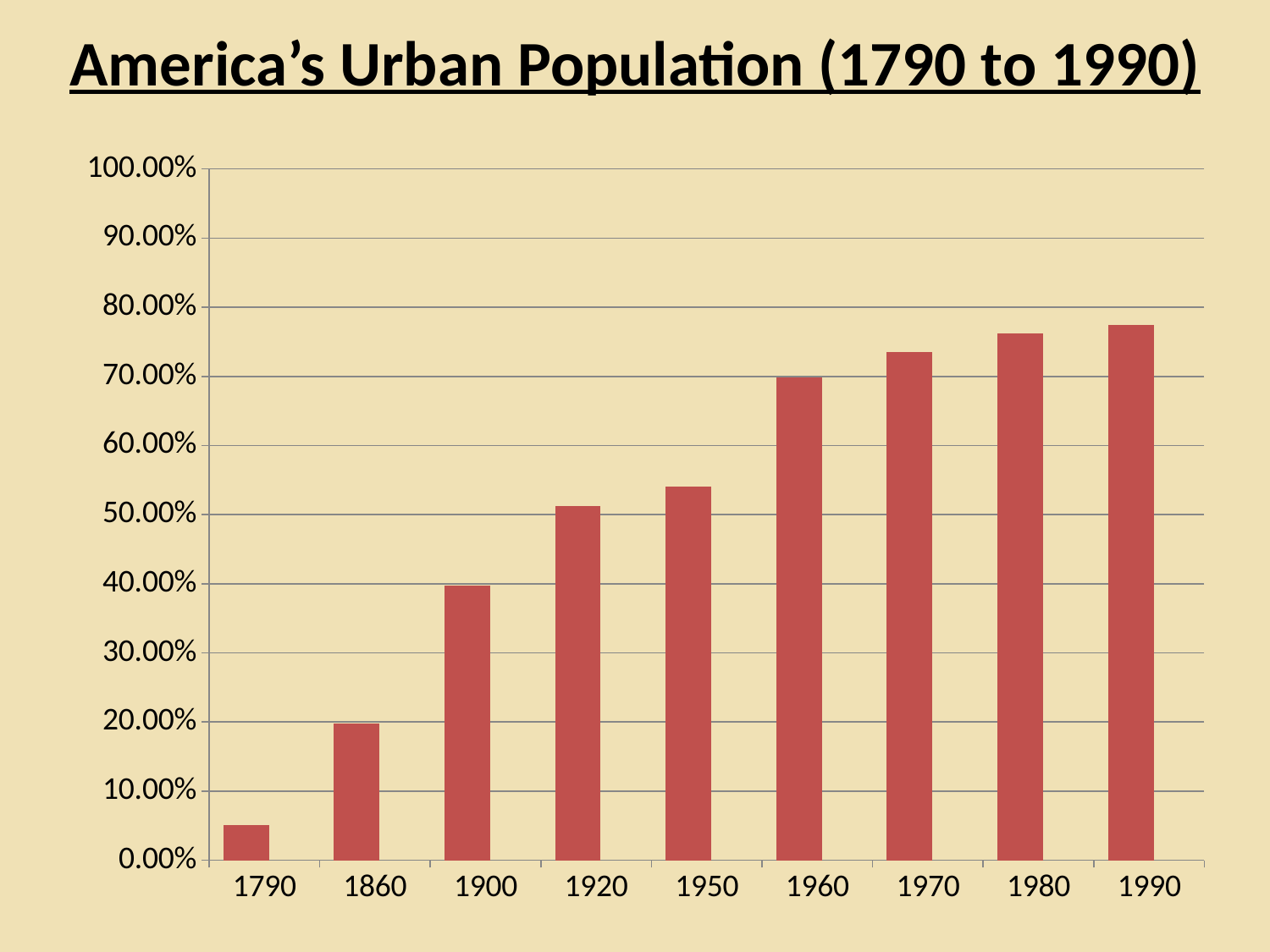
Is the value for 1970 greater or less than 70.00%? greater How many years are shown on the x axis of the chart? 9 Which year has the larger value, 1920 or 1950? 1950 What kind of chart is shown on the slide? bar chart Do the values rise or fall from 1790 to 1990 along the x axis? rise Which year has the highest urban population percentage? 1990 Is the value for 1790 greater or less than 10.00%? less Is the value for 1990 greater or less than 80.00%? less What is the title of the chart? America's Urban Population (1790 to 1990) Which year has the lowest urban population percentage? 1790 Which year has the larger value, 1860 or 1900? 1900